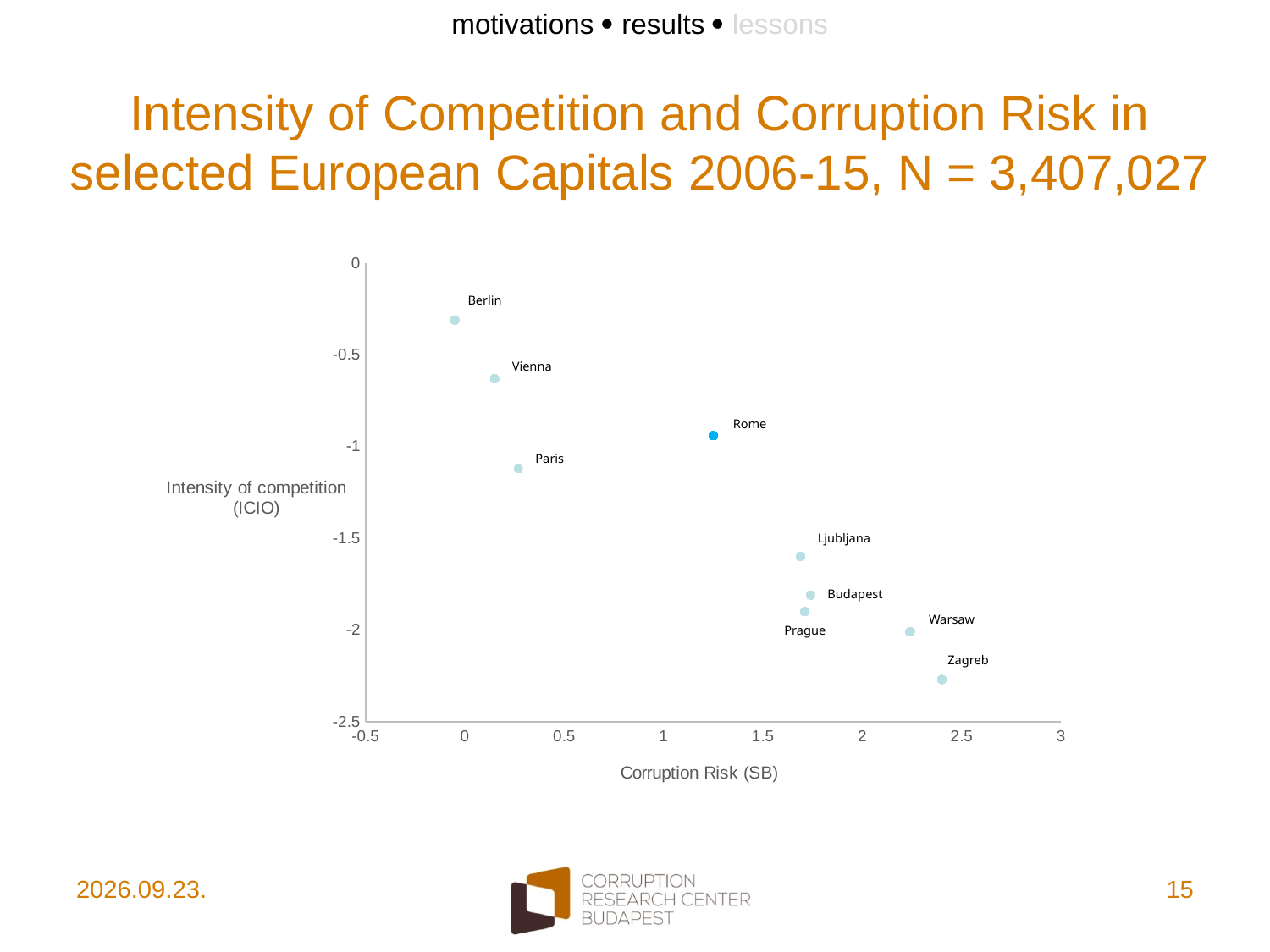
What kind of chart is shown on the slide? Scatter chart Is the corruption risk (SB) for Warsaw greater or less than 2? greater Is the intensity of competition (ICIO) for Zagreb greater or less than -2? less Which capital has the lowest intensity of competition (ICIO)? Zagreb What is the label of the horizontal axis of the chart? Corruption Risk (SB) Is the corruption risk (SB) for Rome greater or less than 1? greater Which capital has the lowest corruption risk (SB)? Berlin As corruption risk (SB) increases along the x axis, does intensity of competition (ICIO) generally rise or fall? Fall Which capital has the highest corruption risk (SB)? Zagreb Which capital has the highest intensity of competition (ICIO)? Berlin How many capitals are plotted on the chart? 9 Which has a higher intensity of competition (ICIO), Berlin or Paris? Berlin